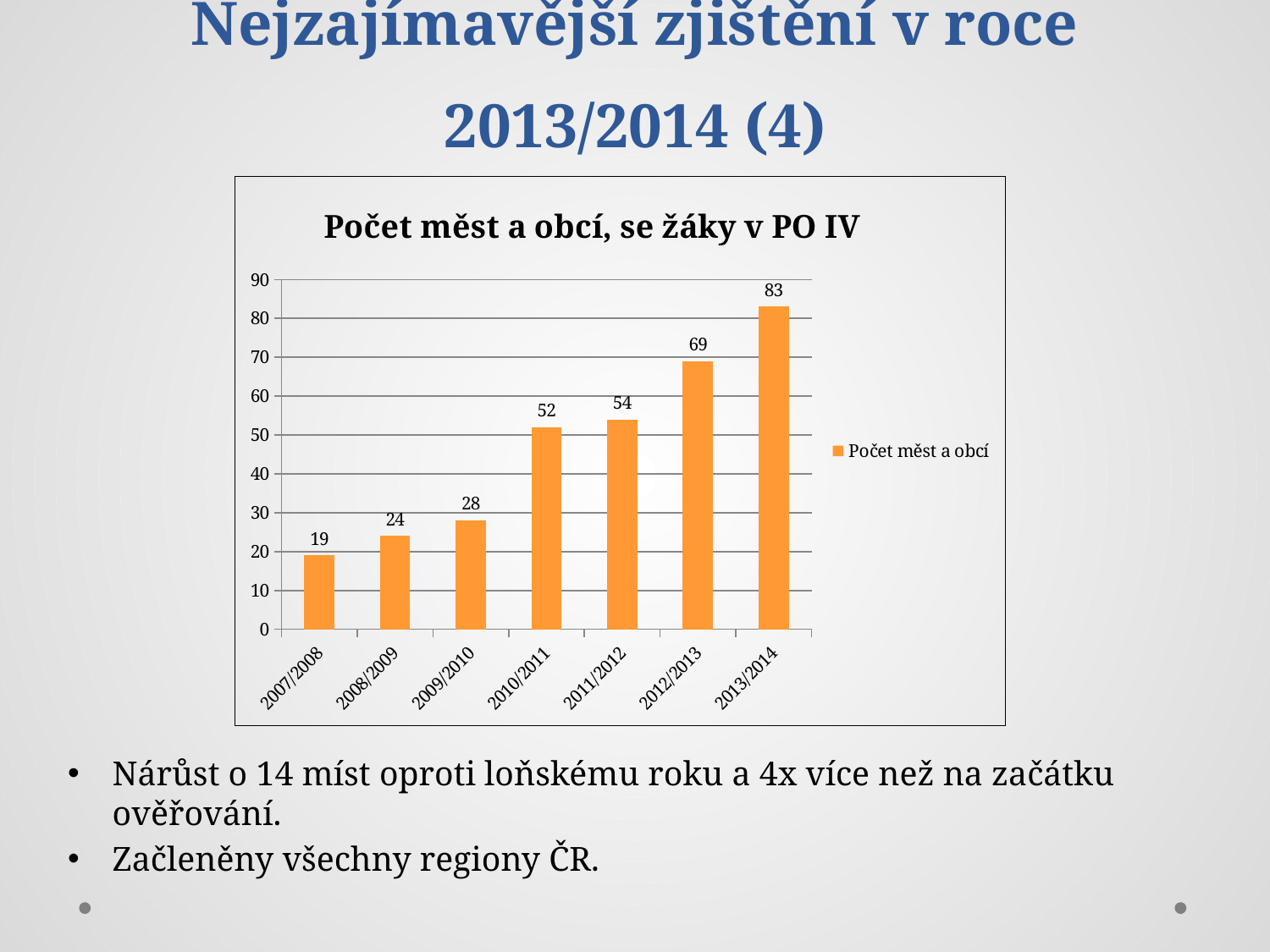
What is the value for 2013/2014? 83 Which is larger, the value for 2011/2012 or the value for 2012/2013? 2012/2013 Do the values rise or fall from 2007/2008 to 2013/2014? rise What kind of chart is shown? bar chart What is the difference between the values for 2009/2010 and 2008/2009? 4 What is the difference between the values for 2013/2014 and 2012/2013? 14 How many series does the legend list? 1 What is the value for 2007/2008? 19 Which year has the highest value? 2013/2014 Which year has the lowest value? 2007/2008 What is the value for 2010/2011? 52 How many years are shown on the x axis? 7